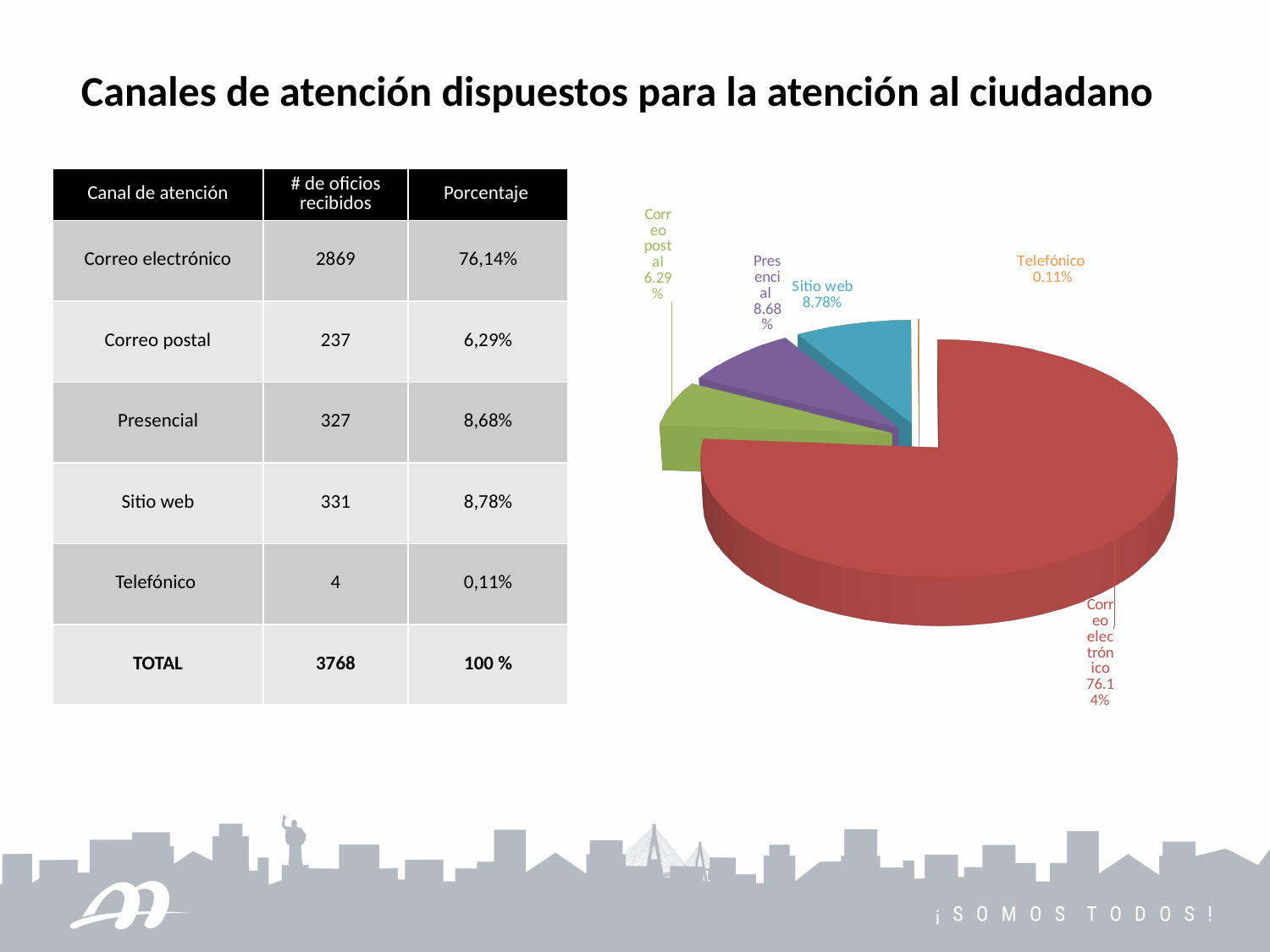
What colour is the Correo electrónico slice in the pie chart? red What is the difference in percentage points between the Correo electrónico slice and the Correo postal slice? 69.85 What share of the pie does Telefónico represent? 0.11% Which category has the largest slice of the pie chart? Correo electrónico Which category has the smallest slice of the pie chart? Telefónico What share of the pie does Presencial represent? 8.68% What kind of chart is shown on the slide? pie chart What share of the pie does Correo electrónico represent? 76.14% Which slice is larger in the pie chart, Correo postal or Presencial? Presencial How many slices does the pie chart have? 5